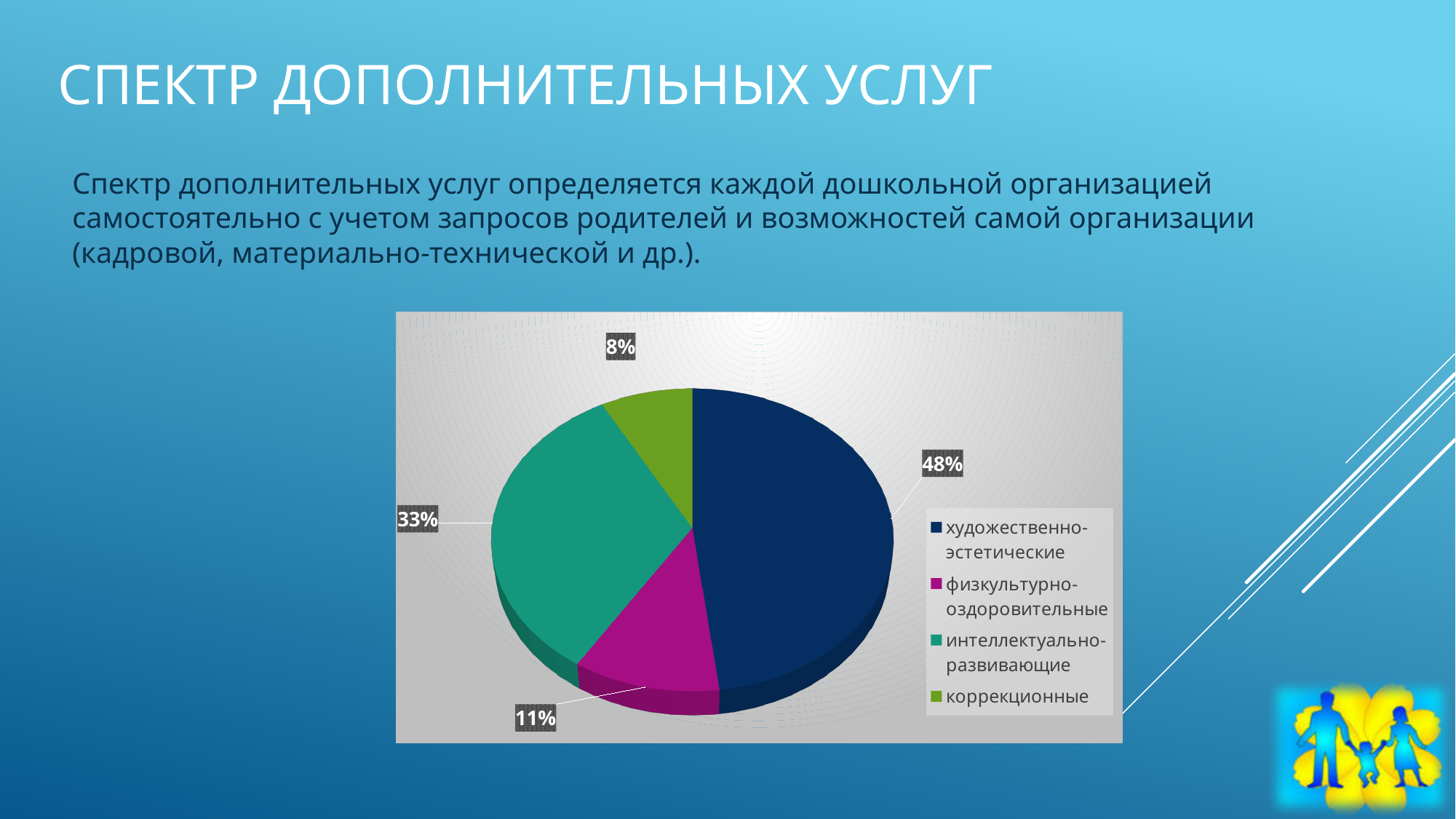
How many entries does the legend list? 4 What colour is the slice for интеллектуально-развивающие? teal What is the difference in percentage points between художественно-эстетические and интеллектуально-развивающие? 15 How many categories does the pie chart show? 4 Which is larger: the slice for физкультурно-оздоровительные or the slice for коррекционные? физкультурно-оздоровительные What share of the pie is labelled for коррекционные? 8% What kind of chart is shown on the slide? pie chart What share of the pie is labelled for художественно-эстетические? 48% Which category has the smallest slice of the pie? коррекционные What share of the pie is labelled for физкультурно-оздоровительные? 11% Which category has the largest slice of the pie? художественно-эстетические What share of the pie is labelled for интеллектуально-развивающие? 33%